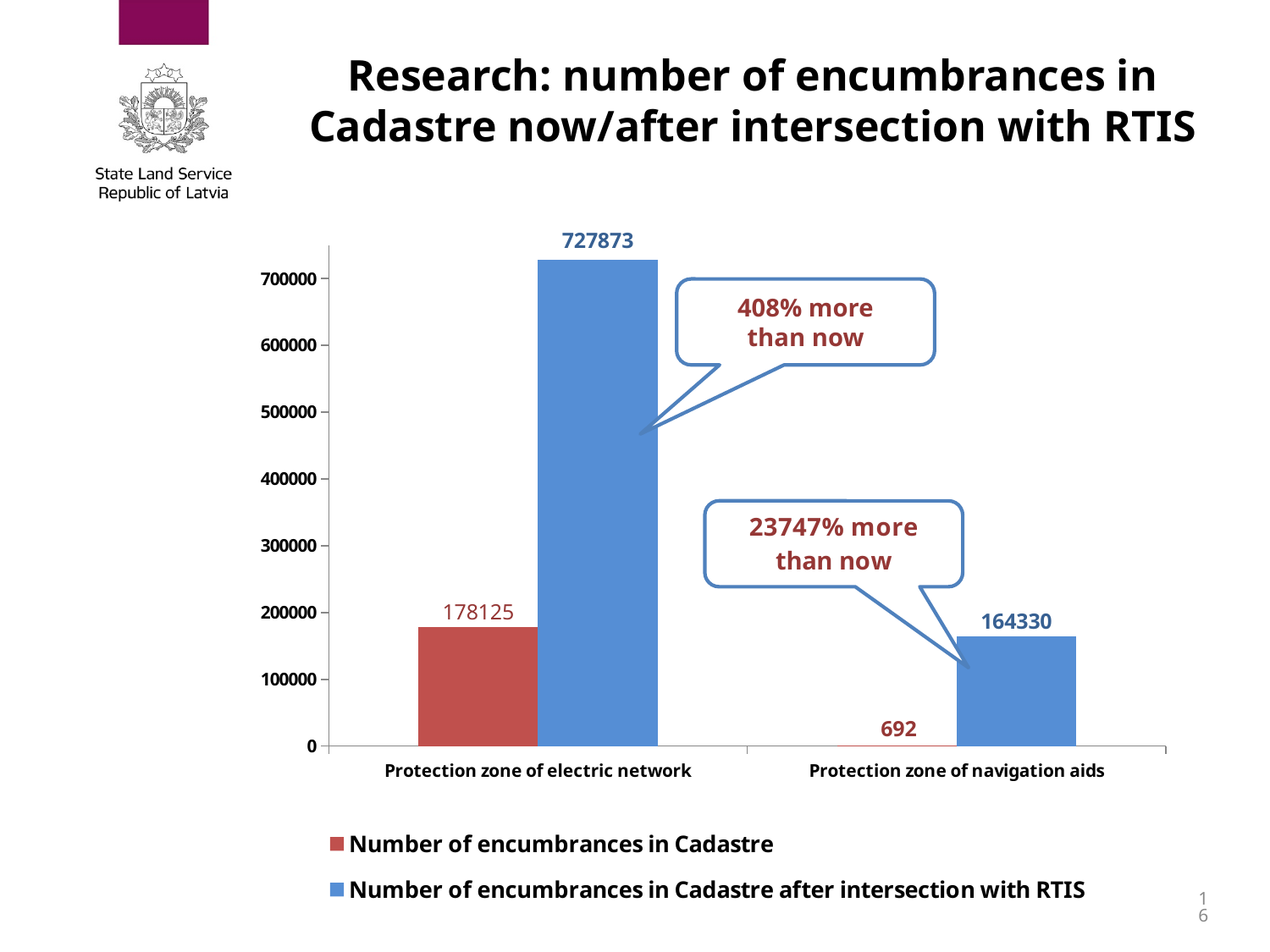
Which bar has the highest value on the chart? Number of encumbrances in Cadastre after intersection with RTIS, Protection zone of electric network How many series does the legend list? 2 What is the difference between the number of encumbrances after intersection with RTIS and the number now for the protection zone of navigation aids? 163638 How many categories are shown on the x axis? 2 What is the number of encumbrances in Cadastre after intersection with RTIS for the protection zone of navigation aids? 164330 What is the number of encumbrances in Cadastre for the protection zone of navigation aids? 692 What is the number of encumbrances in Cadastre after intersection with RTIS for the protection zone of electric network? 727873 Which is larger: the number of encumbrances in Cadastre for the protection zone of electric network, or the number after intersection with RTIS for the protection zone of navigation aids? Number of encumbrances in Cadastre for the protection zone of electric network Which bar has the lowest value on the chart? Number of encumbrances in Cadastre, Protection zone of navigation aids What is the difference between the number of encumbrances after intersection with RTIS and the number now for the protection zone of electric network? 549748 What is the number of encumbrances in Cadastre for the protection zone of electric network? 178125 What kind of chart is shown on the slide? Bar chart